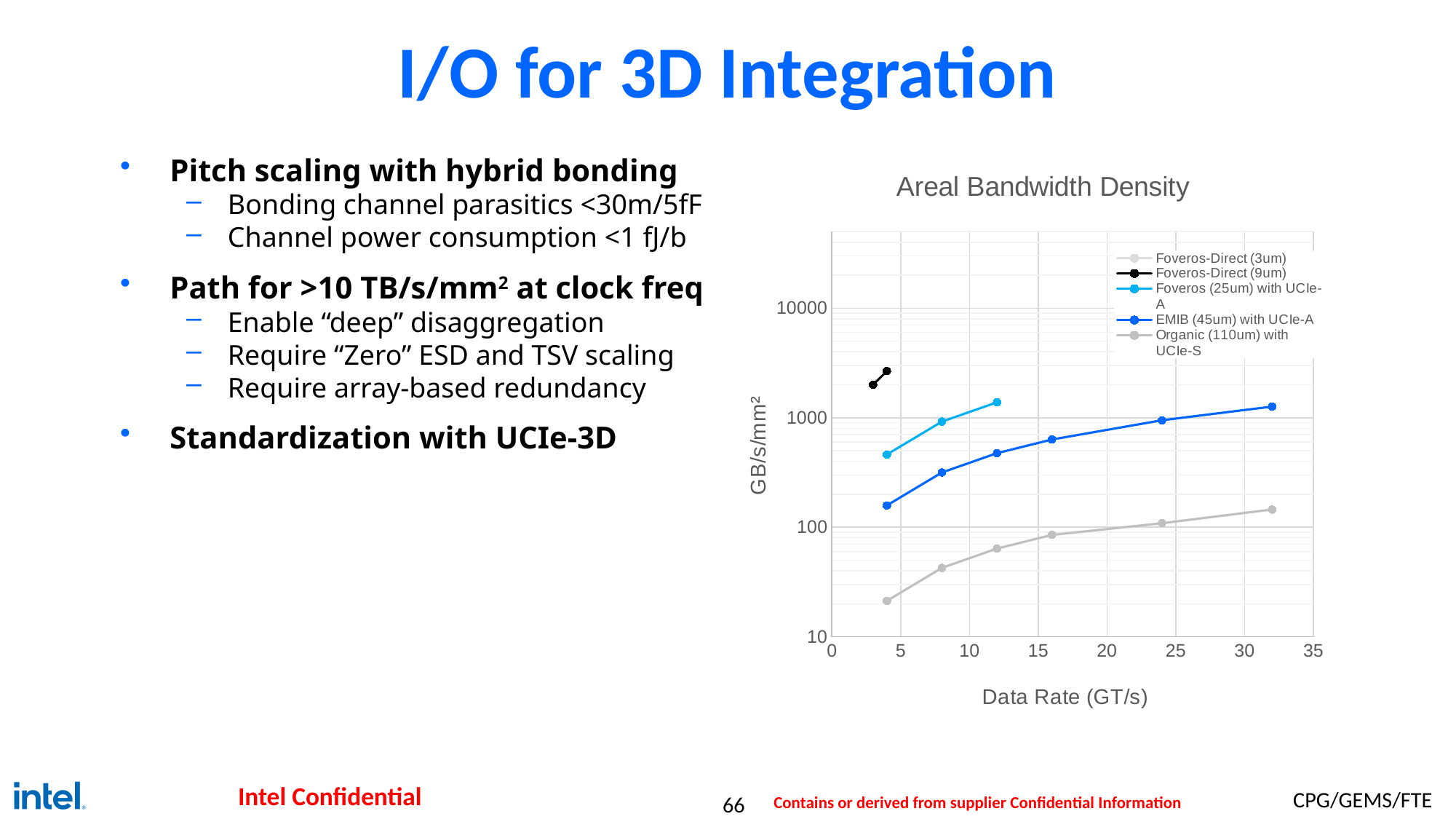
Which series has the highest areal bandwidth density at 4 GT/s? Foveros-Direct (9um) What is the title of the chart? Areal Bandwidth Density Does the areal bandwidth density for the EMIB (45um) with UCIe-A series rise or fall as data rate increases? rise What is the label of the x axis of the chart? Data Rate (GT/s) Is the value for Organic (110um) with UCIe-S at 32 GT/s greater or less than 100 GB/s/mm²? greater Which series has the lowest areal bandwidth density at 32 GT/s? Organic (110um) with UCIe-S Is the value for Organic (110um) with UCIe-S at 4 GT/s greater or less than 100 GB/s/mm²? less Is the value for Foveros (25um) with UCIe-A at 12 GT/s greater or less than 1000 GB/s/mm²? greater What kind of chart is shown on the slide? line chart How many series does the chart legend list? 5 At 8 GT/s, which series has the larger value: Foveros (25um) with UCIe-A or EMIB (45um) with UCIe-A? Foveros (25um) with UCIe-A